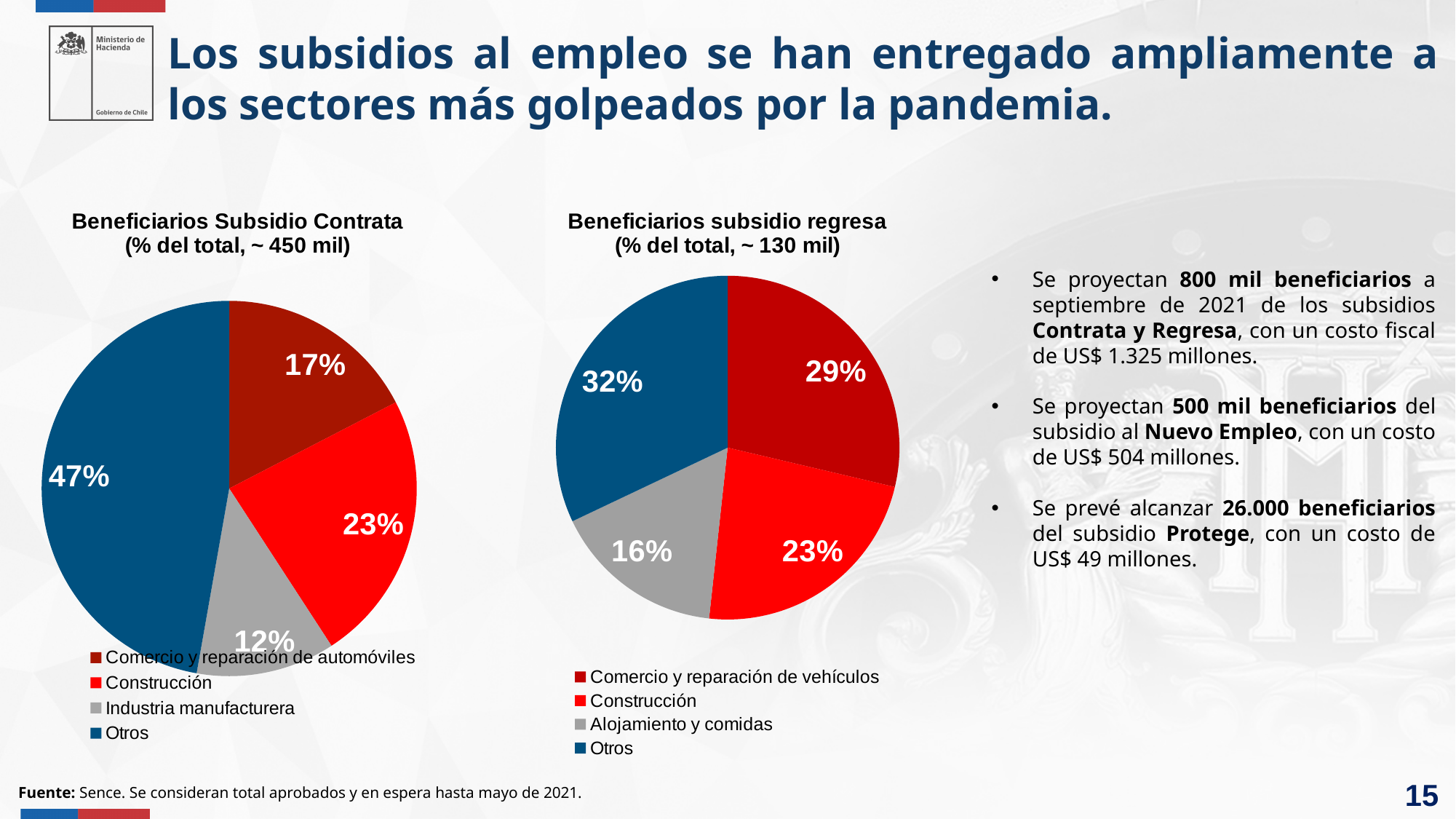
In the 'Beneficiarios subsidio regresa' chart, what share of the total is Alojamiento y comidas? 16% In the 'Beneficiarios Subsidio Contrata' chart, what share of the total is Construcción? 23% What type of chart is used for 'Beneficiarios Subsidio Contrata'? Pie chart In the 'Beneficiarios Subsidio Contrata' chart, what is the difference between the shares of Otros and Construcción? 24 percentage points In the 'Beneficiarios subsidio regresa' chart, which category has the largest share? Otros In the 'Beneficiarios subsidio regresa' chart, which is larger: Comercio y reparación de vehículos or Construcción? Comercio y reparación de vehículos In the 'Beneficiarios Subsidio Contrata' chart, what share of the total is Otros? 47% In the 'Beneficiarios Subsidio Contrata' chart, what colour represents Otros? Dark blue In the 'Beneficiarios Subsidio Contrata' chart, which category has the smallest share? Industria manufacturera In the 'Beneficiarios Subsidio Contrata' chart, what share of the total is Industria manufacturera? 12% How many categories does the 'Beneficiarios subsidio regresa' chart show? 4 In the 'Beneficiarios subsidio regresa' chart, what share of the total is Comercio y reparación de vehículos? 29%